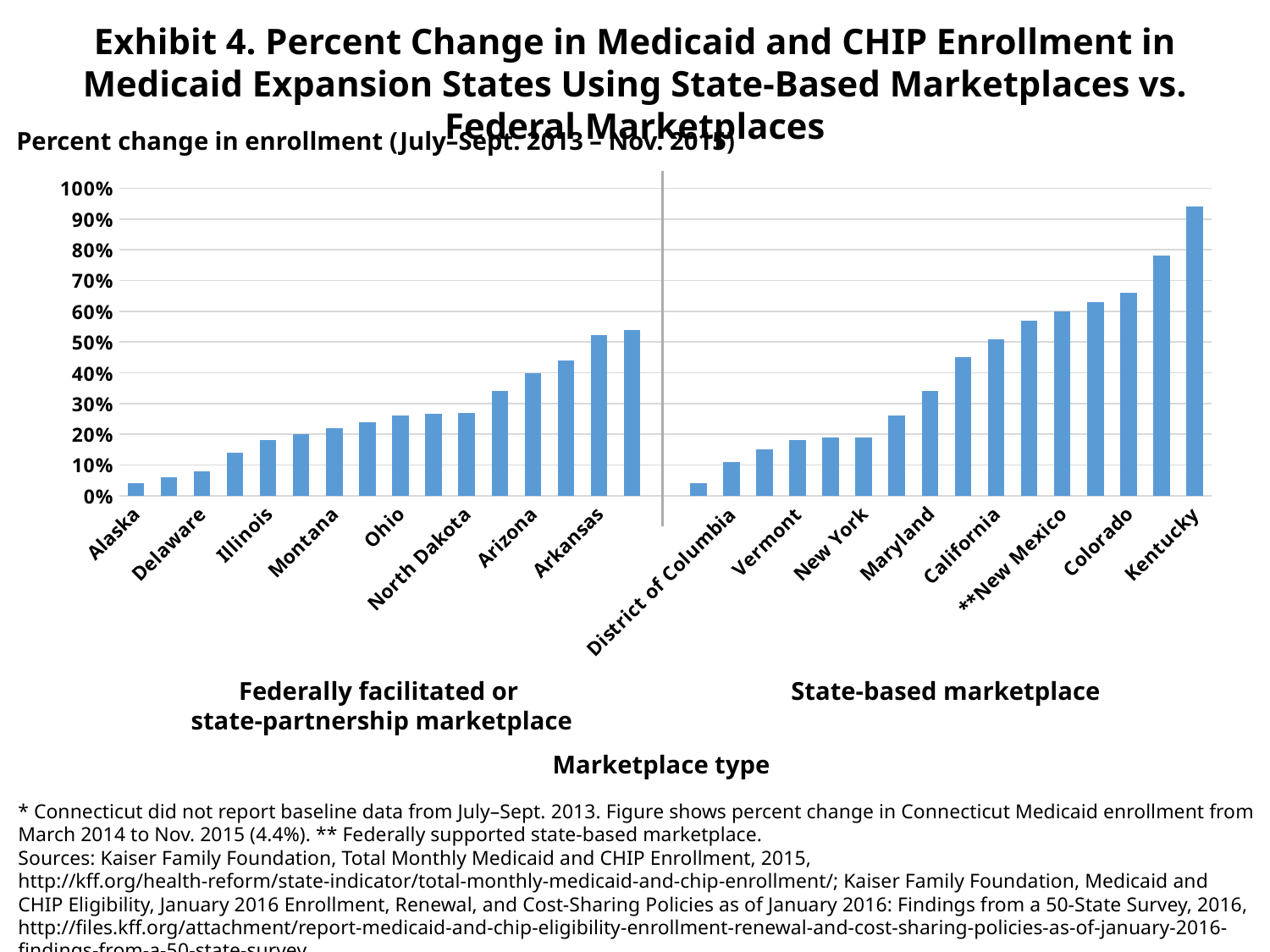
Which marketplace type contains the tallest bar on the chart? State-based marketplace How many bars are shown in the 'Federally facilitated or state-partnership marketplace' group? 16 Is the value for Colorado greater or less than 70%? less Is the value for Kentucky greater or less than 70%? greater What kind of chart is shown on the slide? bar chart What is the title of the horizontal axis? Marketplace type Is the value for California greater or less than 40%? greater Which has the larger percent change in enrollment, Alaska or Kentucky? Kentucky Within each marketplace group, do the bars rise or fall from left to right? rise